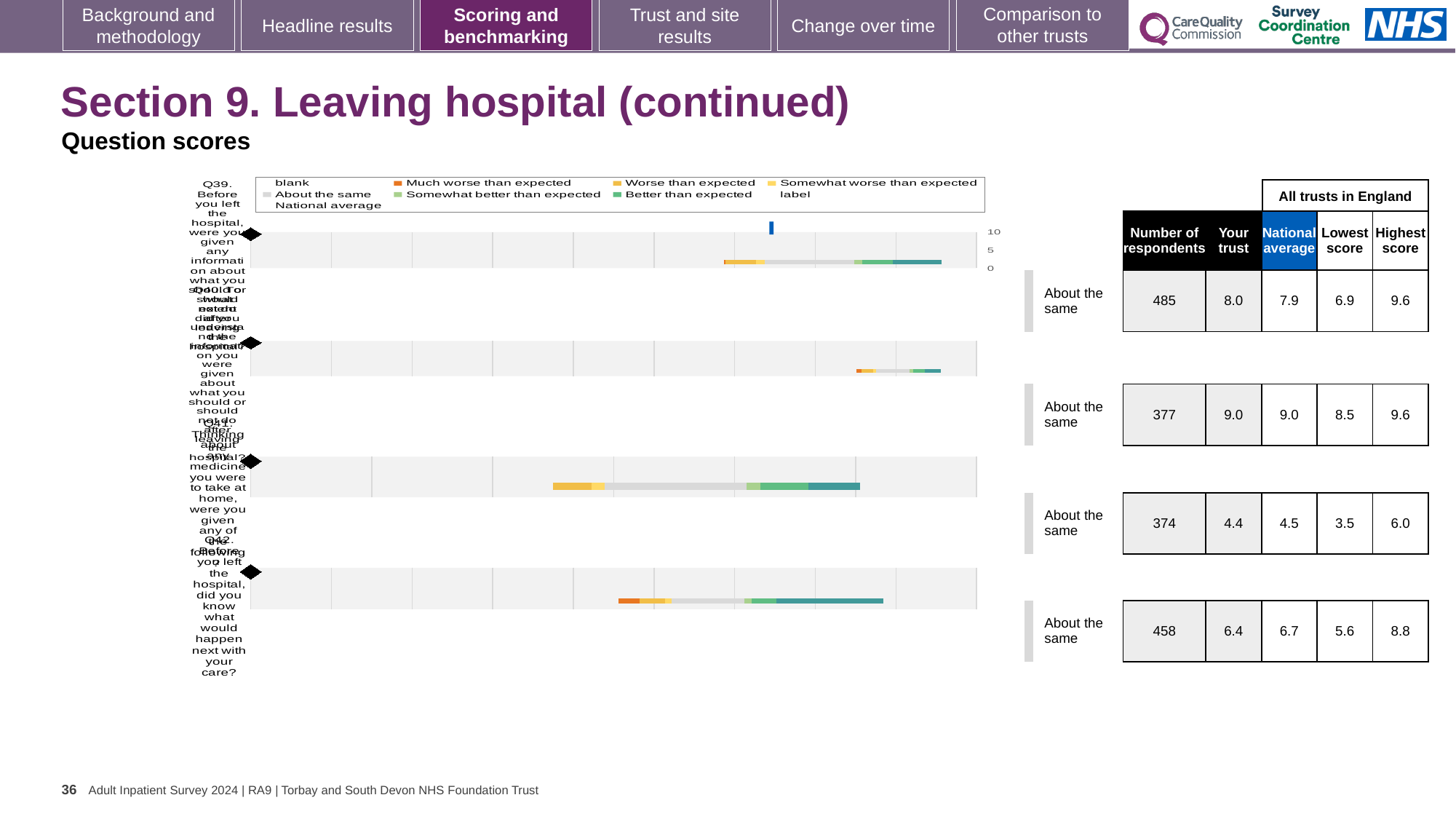
What is the number of respondents for the first question row (Q39)? 485 For the fourth question row (Q42), which is larger: the 'Your trust' score or the national average? National average What benchmark category is shown for all four question rows? About the same What is the national average score for the fourth question row (Q42)? 6.7 What kind of chart is shown on the slide? Horizontal bar chart Which question row has the lowest 'Your trust' score? Q41 (third row) Which question row has the highest 'Your trust' score? Q40 (second row) For the first question row (Q39), what is the difference between the highest score and the lowest score across all trusts in England? 2.7 What is the lowest score across all trusts in England for the third question row (Q41)? 3.5 How many question rows (bars) are plotted in the chart? 4 What is the 'Your trust' score for the third question row (Q41)? 4.4 How many more respondents answered the first question row (Q39) than the second question row (Q40)? 108